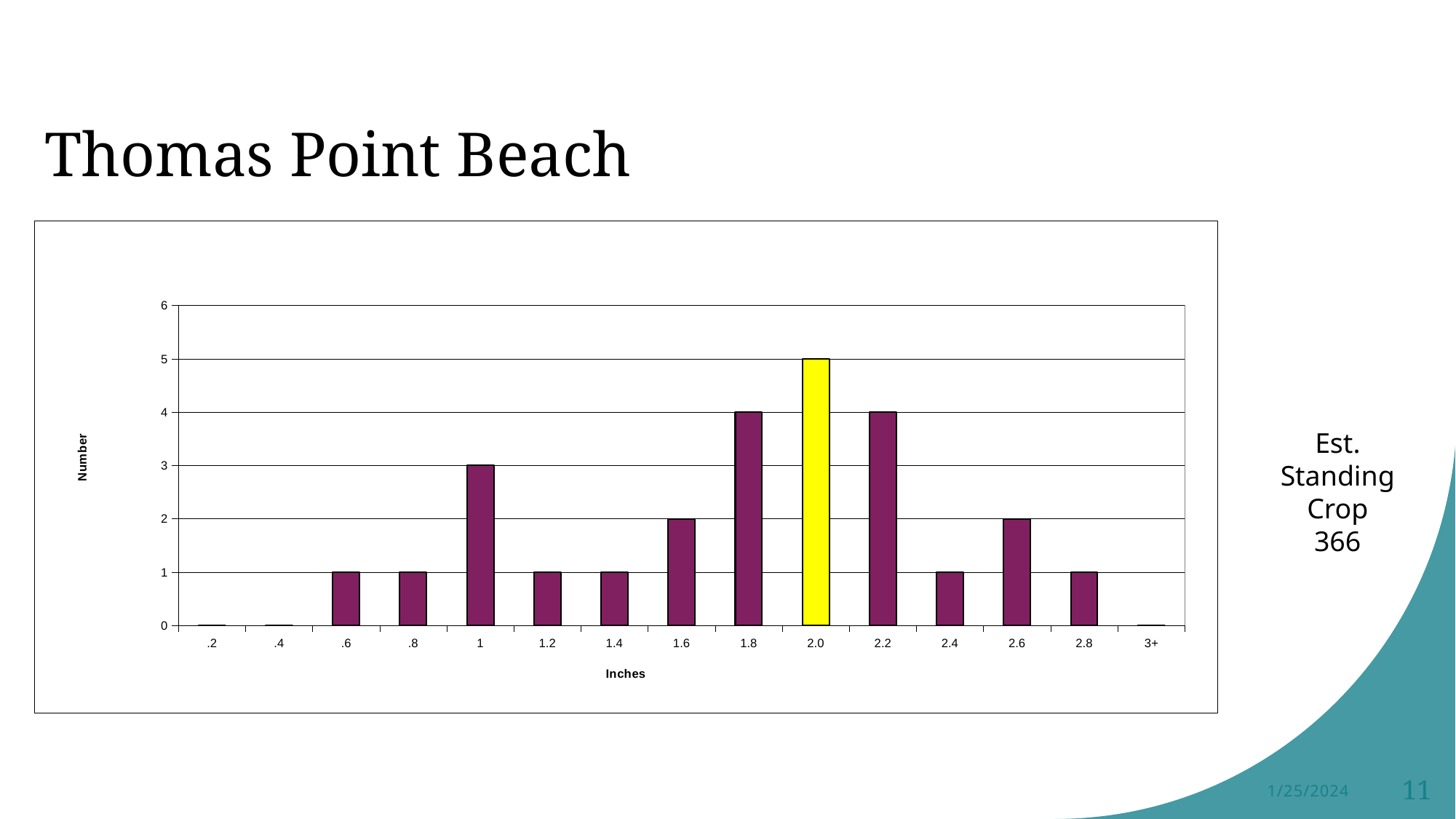
Which bar is coloured yellow instead of purple? 2.0 What is the number for the 2.0 inches category? 5 What is the difference between the number for 2.0 inches and the number for 1.6 inches? 3 What is the number for the 2.6 inches category? 2 What kind of chart is shown on the slide? bar chart Which inches category has the highest number? 2.0 What is the number for the 1.8 inches category? 4 What is the label of the x axis? Inches Which is larger, the number for 1 inch or the number for 2.2 inches? 2.2 inches What is the number for the 1 inch category? 3 How many categories are shown on the x axis? 15 Is the number for 1.8 inches greater or less than 3? greater